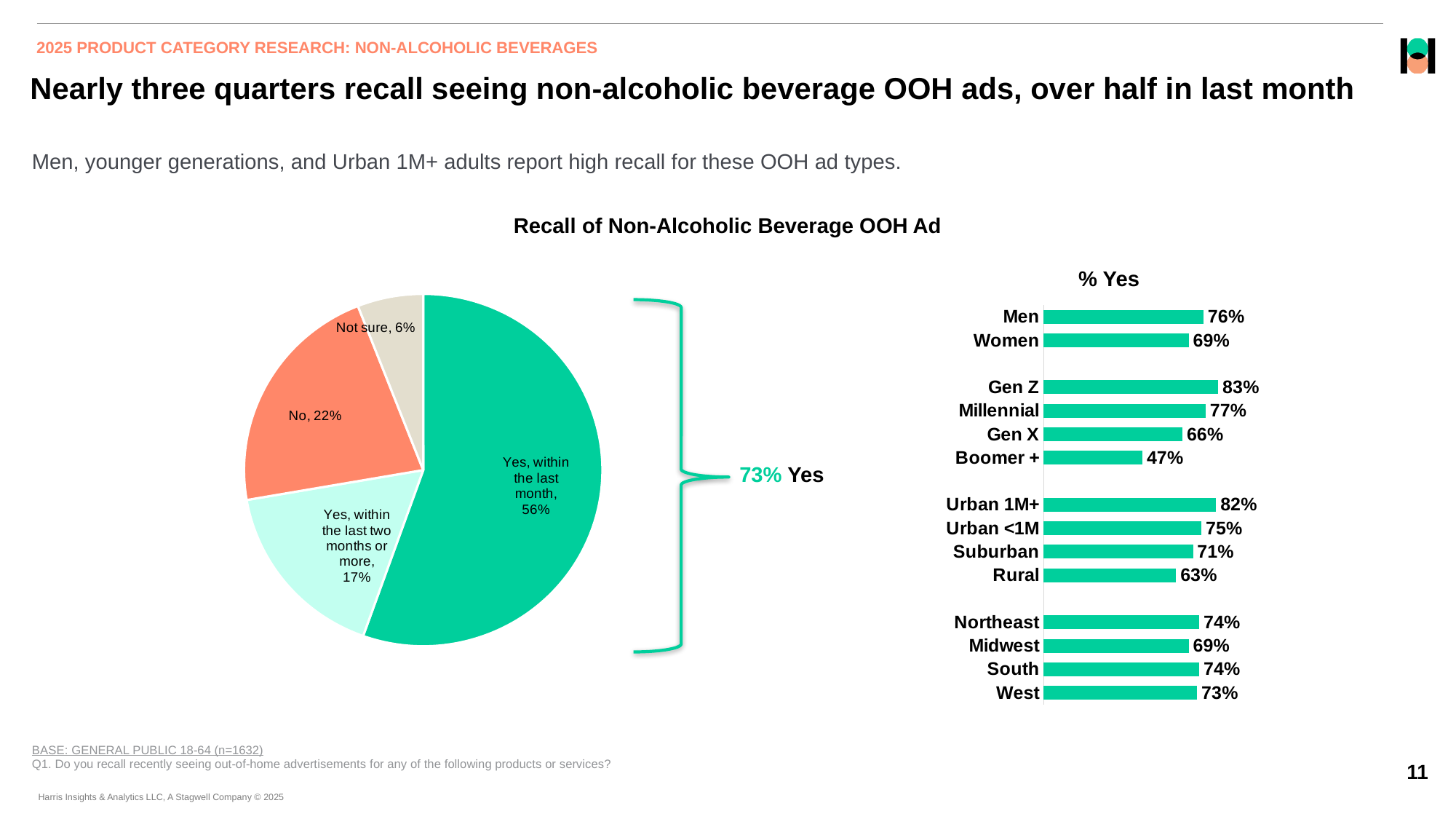
What type of chart is shown on the right side of the slide? Bar chart In the '% Yes' bar chart on the right, which group has the highest value? Gen Z In the '% Yes' bar chart on the right, which group has the lowest value? Boomer + In the '% Yes' bar chart on the right, what is the value for Gen Z? 83% In the pie chart on the left, what share of respondents said 'Yes, within the last month'? 56% In the '% Yes' bar chart on the right, which is larger, Urban 1M+ or Suburban? Urban 1M+ In the pie chart on the left, which response has the smallest slice? Not sure In the '% Yes' bar chart on the right, what is the value for Rural? 63% In the pie chart on the left, what is the combined share of the two 'Yes' slices? 73% In the pie chart on the left, how many slices are there? 4 In the pie chart on the left, what share of respondents answered 'No'? 22% In the '% Yes' bar chart on the right, what is the difference between Men and Women? 7%